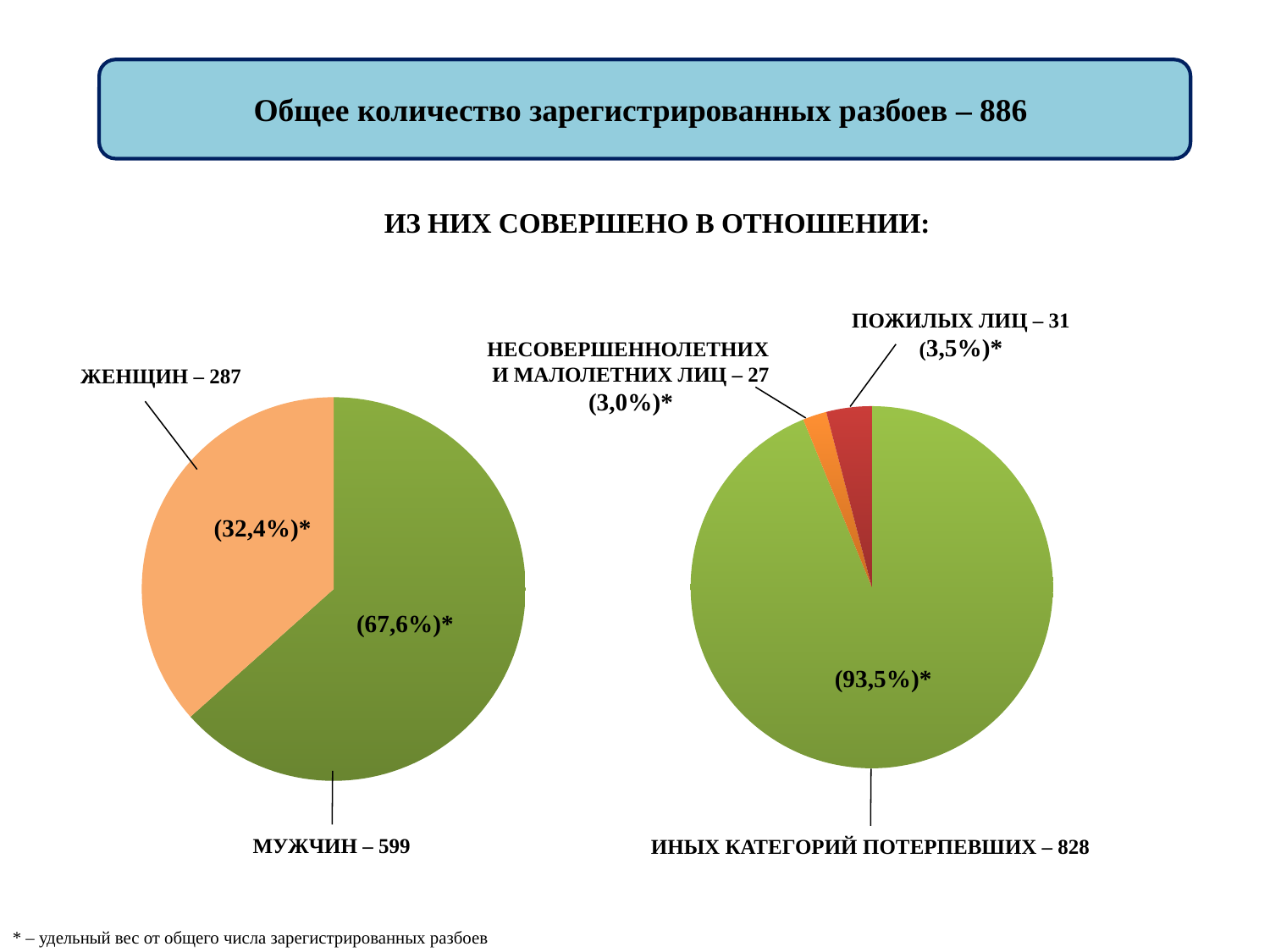
On the left pie chart, which category has the larger slice, women or men? МУЖЧИН On the left pie chart, what is the difference between the number of robberies against men and against women? 312 On the right pie chart, what share of robberies were committed against minors and juveniles (НЕСОВЕРШЕННОЛЕТНИХ И МАЛОЛЕТНИХ ЛИЦ)? 3,0% On the right pie chart, how many slices are there? 3 What type of chart is used on the left side of the slide? Pie chart On the right pie chart, how many robberies were committed against elderly persons (ПОЖИЛЫХ ЛИЦ)? 31 On the right pie chart, what is the difference between the number of robberies against elderly persons and against minors and juveniles? 4 On the right pie chart, which category has the smallest slice? НЕСОВЕРШЕННОЛЕТНИХ И МАЛОЛЕТНИХ ЛИЦ On the left pie chart, what share of robberies were committed against men (МУЖЧИН)? 67,6% On the right pie chart, which category has the largest slice? ИНЫХ КАТЕГОРИЙ ПОТЕРПЕВШИХ What total number of registered robberies is stated in the header box at the top of the slide? 886 On the left pie chart, how many robberies were committed against women (ЖЕНЩИН)? 287